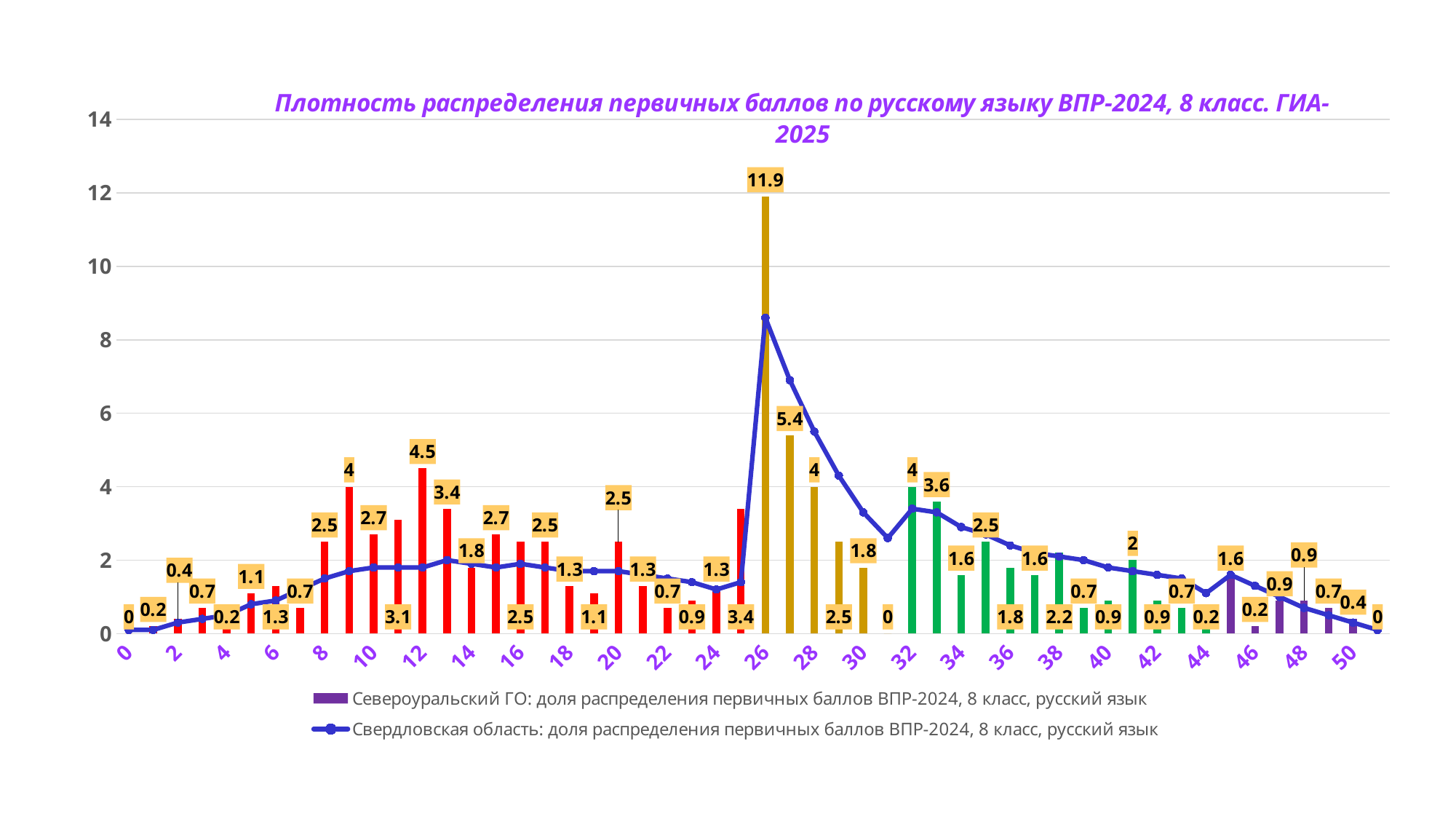
What is the value of the Североуральский ГО bar at score 27? 5.4 What is the value of the Североуральский ГО bar at score 33? 3.6 What kind of chart is shown on the slide? Combined bar and line chart How many series does the legend list? 2 Is the Свердловская область line value at score 26 greater or less than 8? greater What is the difference between the Североуральский ГО values at scores 26 and 27? 6.5 Which series is drawn as a line with markers? Свердловская область What is the value of the Североуральский ГО bar at score 26? 11.9 What is the value of the Североуральский ГО bar at score 12? 4.5 Which is larger for Североуральский ГО: the value at score 9 or at score 13? score 9 Is the Свердловская область line value at score 0 greater or less than 2? less At which score does the Североуральский ГО series reach its highest value? 26